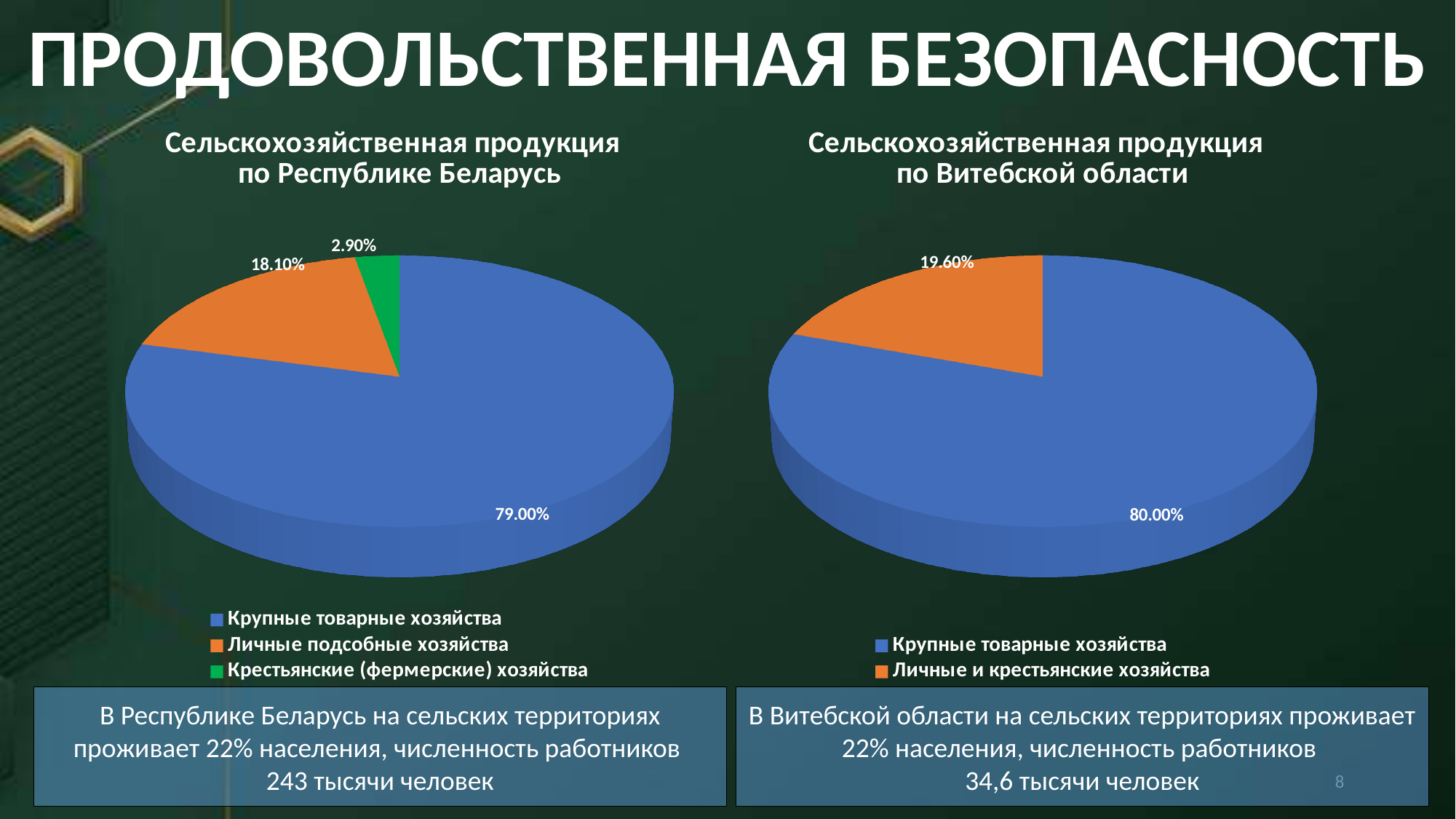
In the chart 'Сельскохозяйственная продукция по Республике Беларусь', what share do Крестьянские (фермерские) хозяйства have? 2.90% In the chart 'Сельскохозяйственная продукция по Республике Беларусь', what share do Крупные товарные хозяйства have? 79.00% In the chart 'Сельскохозяйственная продукция по Республике Беларусь', what is the difference in percentage points between Личные подсобные хозяйства and Крестьянские (фермерские) хозяйства? 15.20% In the chart 'Сельскохозяйственная продукция по Витебской области', what share do Личные и крестьянские хозяйства have? 19.60% In the chart 'Сельскохозяйственная продукция по Витебской области', what is the difference in percentage points between Крупные товарные хозяйства and Личные и крестьянские хозяйства? 60.40% In the chart 'Сельскохозяйственная продукция по Республике Беларусь', which category has the smallest share? Крестьянские (фермерские) хозяйства In the chart 'Сельскохозяйственная продукция по Республике Беларусь', which category has the largest share? Крупные товарные хозяйства In the chart 'Сельскохозяйственная продукция по Витебской области', what share do Крупные товарные хозяйства have? 80.00% How many slices does the chart 'Сельскохозяйственная продукция по Витебской области' have? 2 How many slices does the chart 'Сельскохозяйственная продукция по Республике Беларусь' have? 3 In the chart 'Сельскохозяйственная продукция по Республике Беларусь', what share do Личные подсобные хозяйства have? 18.10% What type of chart is 'Сельскохозяйственная продукция по Витебской области'? Pie chart